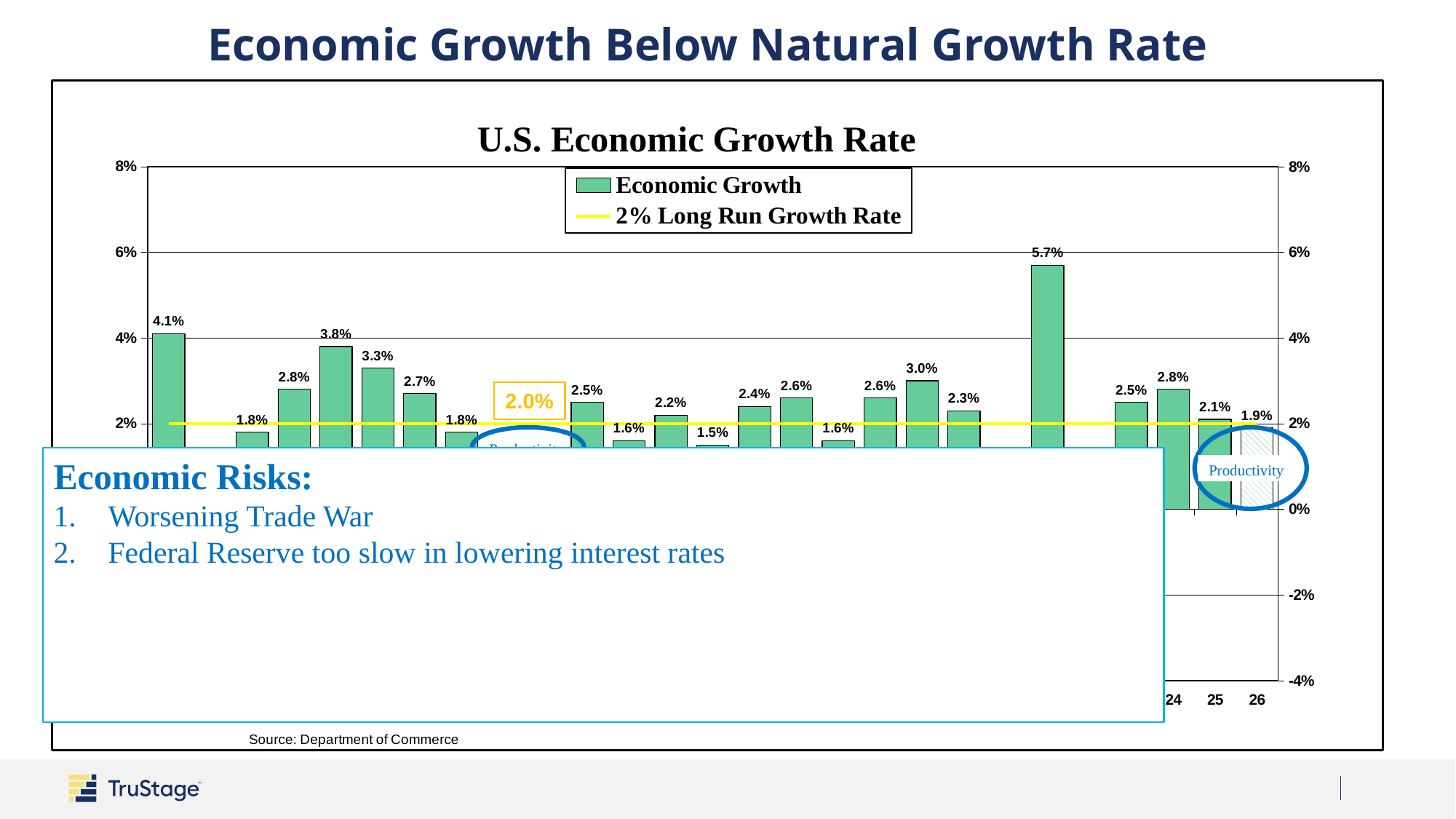
What are the two entries in the chart legend? Economic Growth; 2% Long Run Growth Rate What is the title of the chart? U.S. Economic Growth Rate What is the difference between the growth rates for 24 and 25? 0.7% What kind of chart is used to show economic growth? bar chart What is the economic growth rate shown for 25? 2.1% Which has the higher growth rate, 25 or 26? 25 What is the economic growth rate shown for 24? 2.8% What is the economic growth rate shown for 26? 1.9% Is the tallest bar on the chart greater or less than 4%? greater What value is labeled on the long run growth rate line? 2.0% How many series does the legend list? 2 What is the highest economic growth rate labeled on the chart? 5.7%